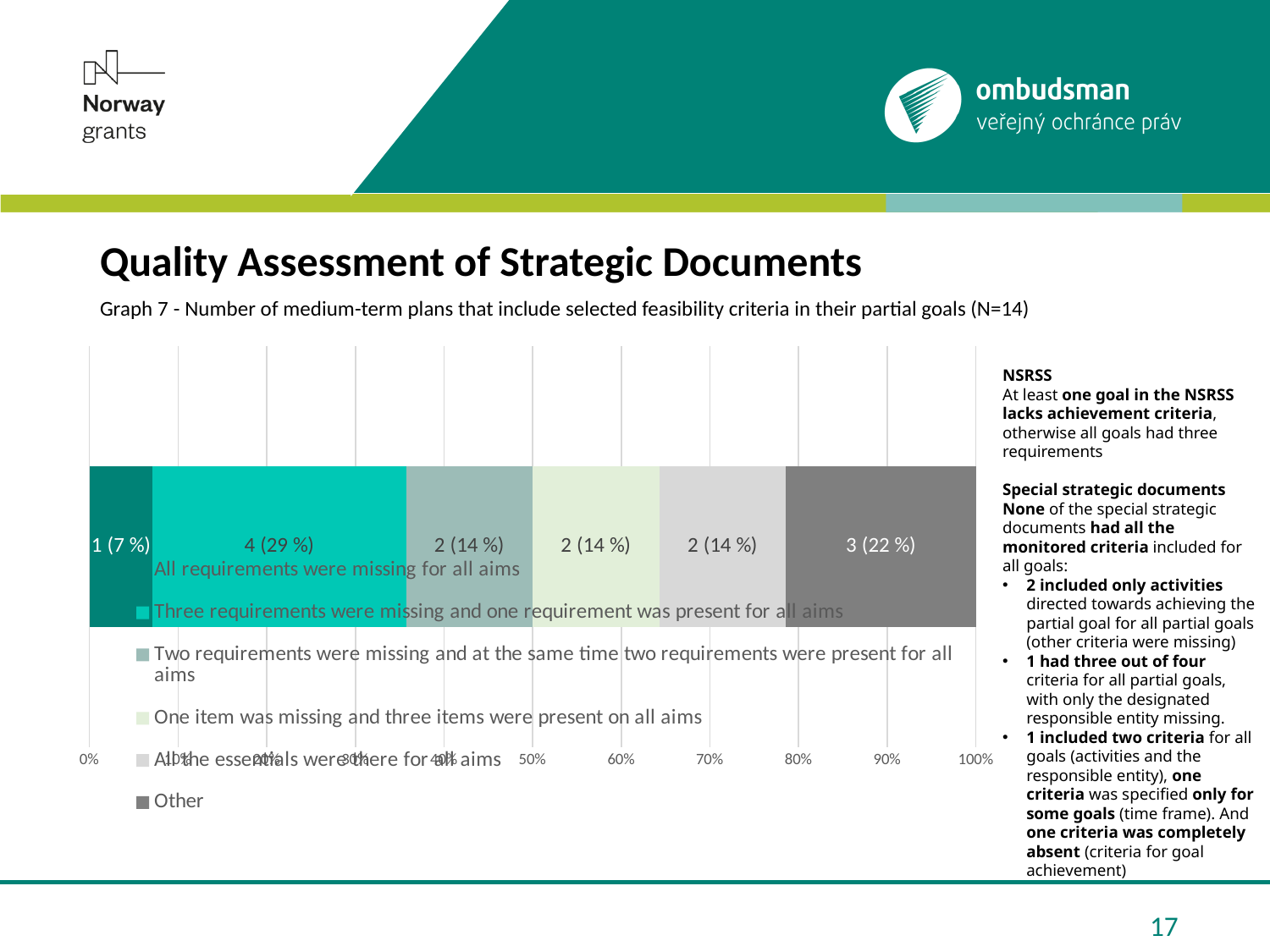
Which legend category has the largest segment in the bar? Three requirements were missing and one requirement was present for all aims What is the title of the graph shown on the slide? Graph 7 - Number of medium-term plans that include selected feasibility criteria in their partial goals (N=14) What is the value shown for 'Three requirements were missing and one requirement was present for all aims'? 4 (29 %) What is the value shown for 'All requirements were missing for all aims'? 1 (7 %) How many series does the legend list? 6 Which legend category has the smallest segment in the bar? All requirements were missing for all aims What is the value shown for 'All the essentials were there for all aims'? 2 (14 %) What is the value shown for the 'Other' segment? 3 (22 %) What is the difference in the number of plans between 'Three requirements were missing and one requirement was present for all aims' and 'Other'? 1 What kind of chart is shown on the slide? bar chart Which is larger: the 'Other' segment or the 'All requirements were missing for all aims' segment? Other What is the total number of plans across all segments of the stacked bar? 14